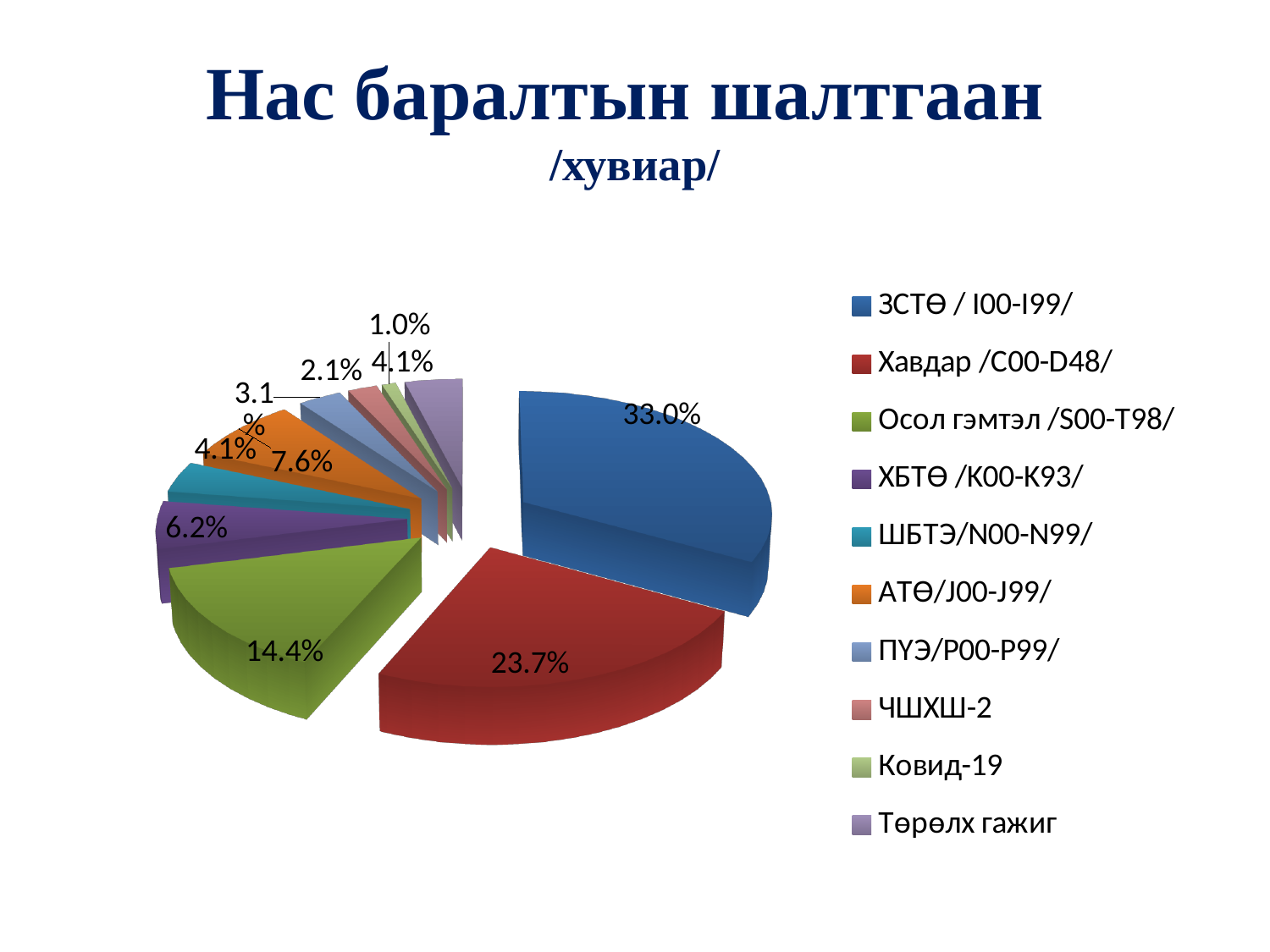
Which category has the largest share of the pie? ЗСТӨ / I00-I99/ Which is larger, the share for Осол гэмтэл /S00-T98/ or the share for АТӨ/J00-J99/? Осол гэмтэл /S00-T98/ What is the share for Осол гэмтэл /S00-T98/? 14.4% What is the difference between the shares of ЗСТӨ / I00-I99/ and Хавдар /C00-D48/? 9.3% What is the share for Хавдар /C00-D48/? 23.7% What is the share for ЗСТӨ / I00-I99/? 33.0% What is the share for Ковид-19? 1.0% What is the share for АТӨ/J00-J99/? 7.6% How many categories does the legend list? 10 What type of chart is shown on the slide? Pie chart What is the share for ХБТӨ /K00-K93/? 6.2% Which category has the smallest share of the pie? Ковид-19